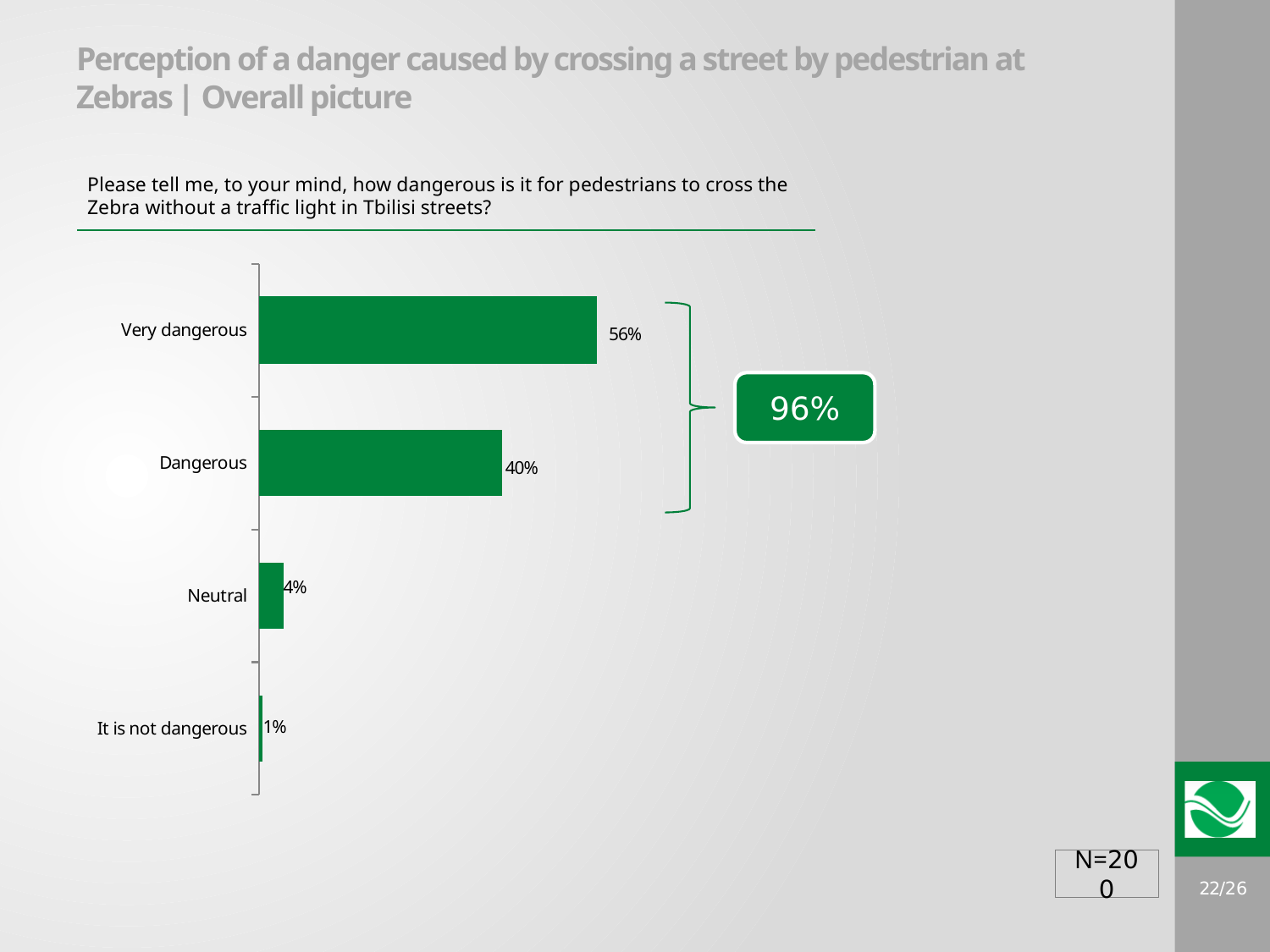
What is the value shown for the "Dangerous" category? 40% Which is larger, the value for "Neutral" or the value for "It is not dangerous"? Neutral Which category has the lowest value? It is not dangerous What is the sample size (N) shown on the slide? N=200 What is the value for "It is not dangerous"? 1% What kind of chart is shown on the slide? Bar chart Which category has the highest value? Very dangerous How many categories are shown in the chart? 4 What percentage of respondents said crossing the Zebra is "Very dangerous"? 56% What percentage of respondents answered "Neutral"? 4% What is the difference between the "Very dangerous" and "Dangerous" values? 16 percentage points What combined percentage is shown by the bracket grouping "Very dangerous" and "Dangerous"? 96%